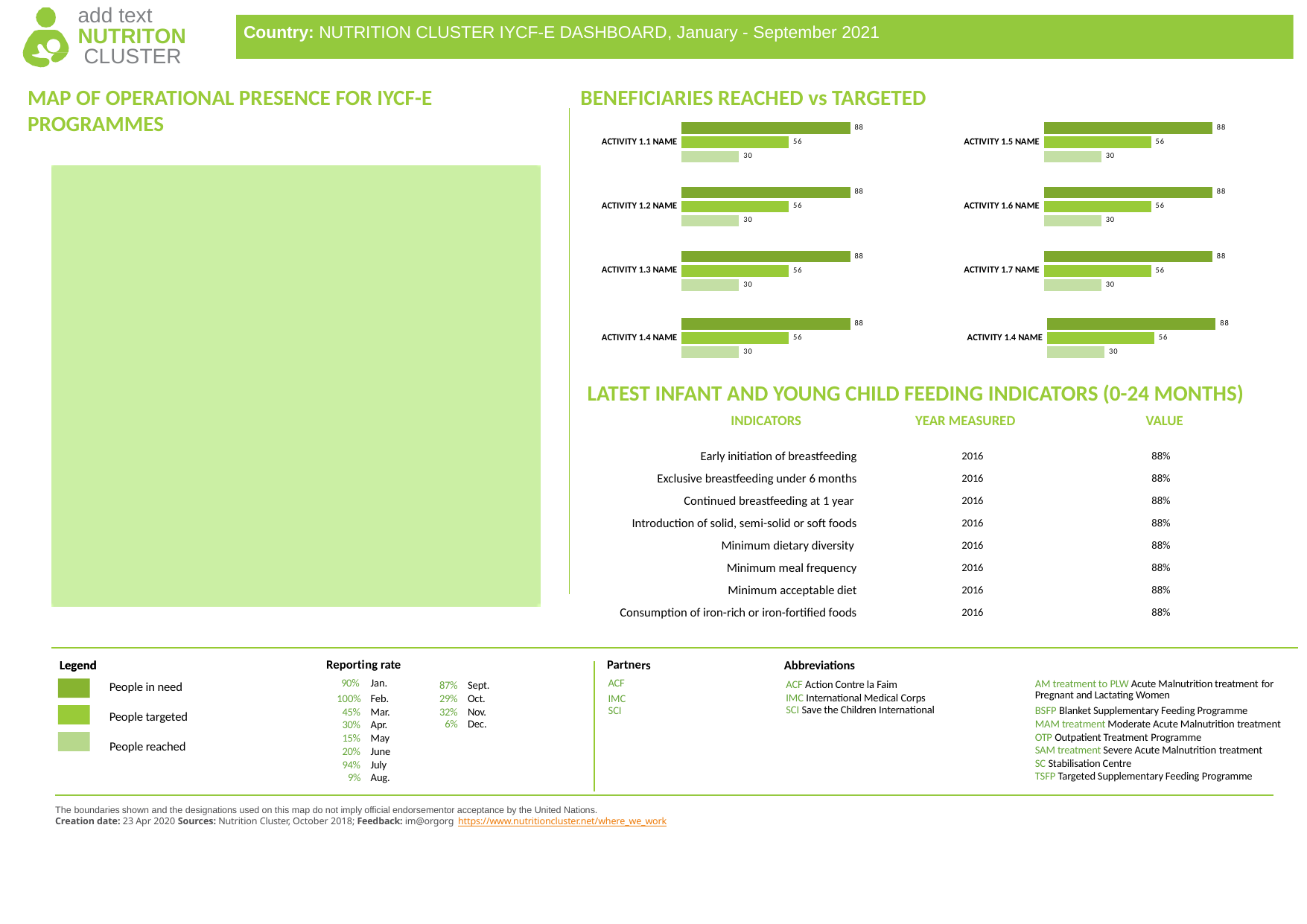
According to the legend, which series is shown in the lightest green in the BENEFICIARIES REACHED vs TARGETED chart? People reached In the BENEFICIARIES REACHED vs TARGETED chart, which series has the highest value for ACTIVITY 1.4 NAME? People in need In the BENEFICIARIES REACHED vs TARGETED chart, what value is labelled on the top (dark green) bar for ACTIVITY 1.1 NAME? 88 In the BENEFICIARIES REACHED vs TARGETED chart, for ACTIVITY 1.7 NAME, which is larger: the middle bar or the bottom bar? the middle bar (56) What kind of chart is used in the BENEFICIARIES REACHED vs TARGETED section? bar chart In the BENEFICIARIES REACHED vs TARGETED chart, what is the difference between the top bar and the middle bar for ACTIVITY 1.6 NAME? 32 How many activity groups are shown in the BENEFICIARIES REACHED vs TARGETED chart? 8 In the BENEFICIARIES REACHED vs TARGETED chart, what is the difference between the top bar (88) and the bottom bar (30) for ACTIVITY 1.2 NAME? 58 What is the title of the bar chart on the right side of the slide? BENEFICIARIES REACHED vs TARGETED In the BENEFICIARIES REACHED vs TARGETED chart, what value is labelled on the bottom (light green) bar for ACTIVITY 1.5 NAME? 30 How many series does the legend list for the BENEFICIARIES REACHED vs TARGETED bar chart? 3 In the BENEFICIARIES REACHED vs TARGETED chart, what value is labelled on the middle bar for ACTIVITY 1.3 NAME? 56